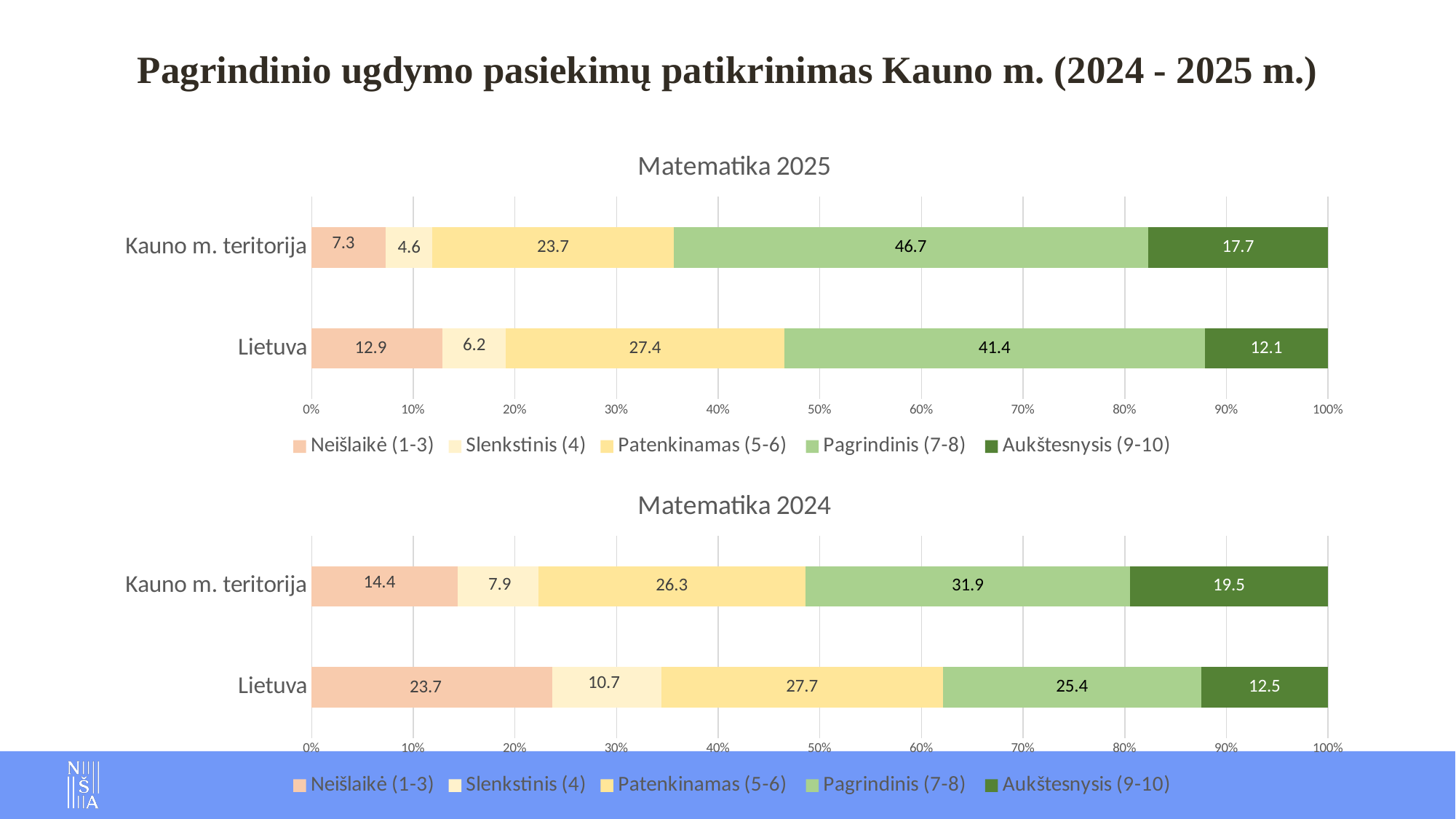
In the Matematika 2025 chart, what is the Pagrindinis (7-8) value for Kauno m. teritorija? 46.7 What type of chart is the Matematika 2024 chart? Stacked bar chart In the Matematika 2025 chart, which series has the largest value for Lietuva? Pagrindinis (7-8) In the Matematika 2025 chart, what is the difference between the Pagrindinis (7-8) values for Kauno m. teritorija and Lietuva? 5.3 How many categories are shown in the Matematika 2025 chart? 2 How many series does the legend of the Matematika 2025 chart list? 5 In the Matematika 2024 chart, which has the larger Neišlaikė (1-3) value, Kauno m. teritorija or Lietuva? Lietuva In the Matematika 2024 chart, which series has the smallest value for Kauno m. teritorija? Slenkstinis (4) In the Matematika 2025 chart, what is the Neišlaikė (1-3) value for Lietuva? 12.9 In the Matematika 2024 chart, what is the difference between the Neišlaikė (1-3) values for Lietuva and Kauno m. teritorija? 9.3 In the Matematika 2024 chart, what is the Aukštesnysis (9-10) value for Kauno m. teritorija? 19.5 In the Matematika 2024 chart, what is the Slenkstinis (4) value for Lietuva? 10.7